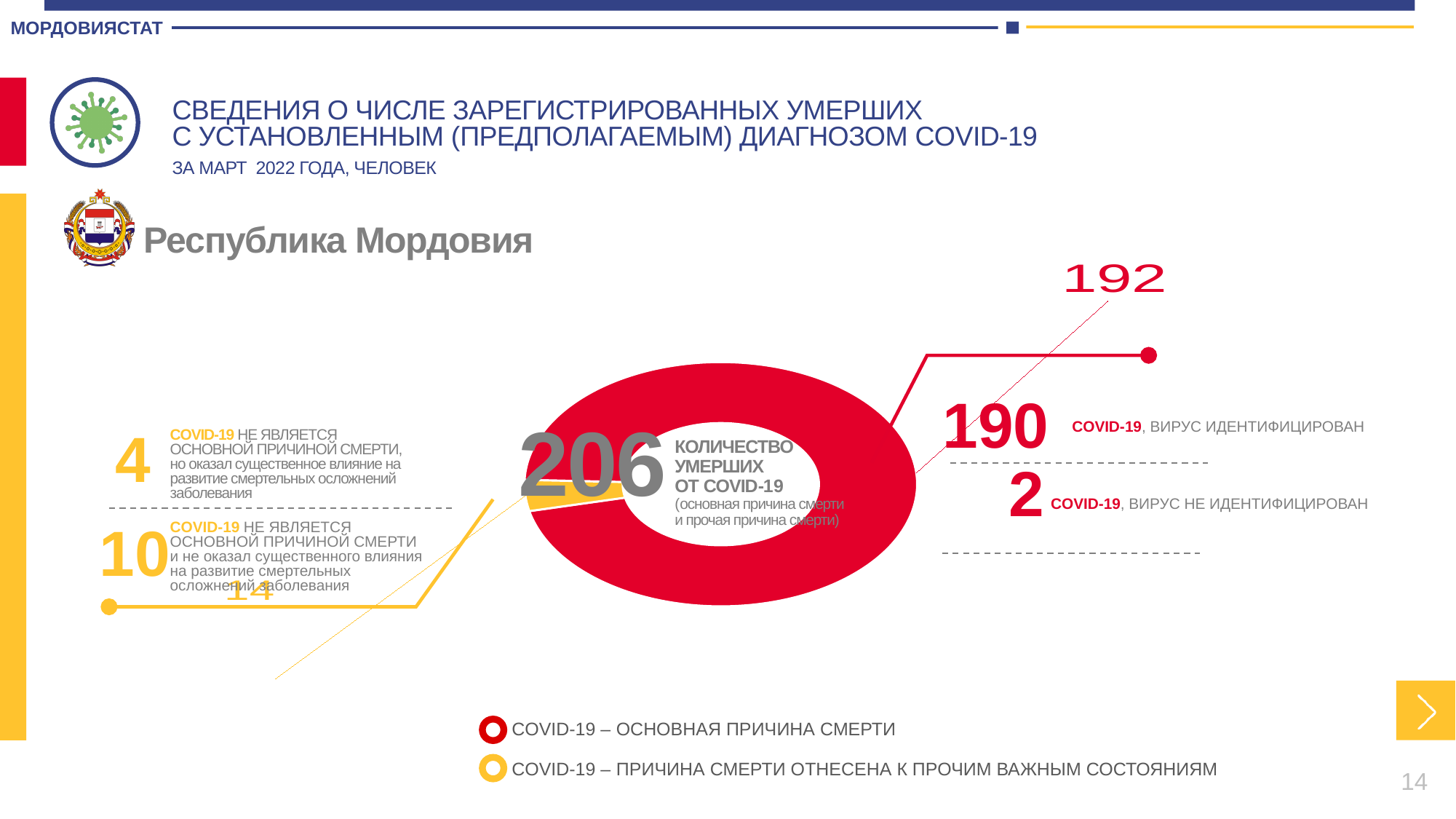
What is the difference between the red slice (192) and the yellow slice (14)? 178 What kind of chart is shown on the slide? Pie chart (donut) Which slice of the donut chart is the smallest? COVID-19 – причина смерти отнесена к прочим важным состояниям (14) Which region does the chart refer to? Республика Мордовия What is the value of the red slice (COVID-19 – основная причина смерти)? 192 What is the value of the yellow slice (COVID-19 – причина смерти отнесена к прочим важным состояниям)? 14 Which slice of the donut chart is the largest? COVID-19 – основная причина смерти (192) How many deaths are listed where COVID-19 was not the main cause but had a significant influence on the development of fatal complications? 4 What is the total number of deaths from COVID-19 shown in the centre of the donut chart? 206 How many deaths are listed as COVID-19 with the virus not identified? 2 How many slices does the donut chart have? 2 How many deaths are listed as COVID-19 with the virus identified? 190